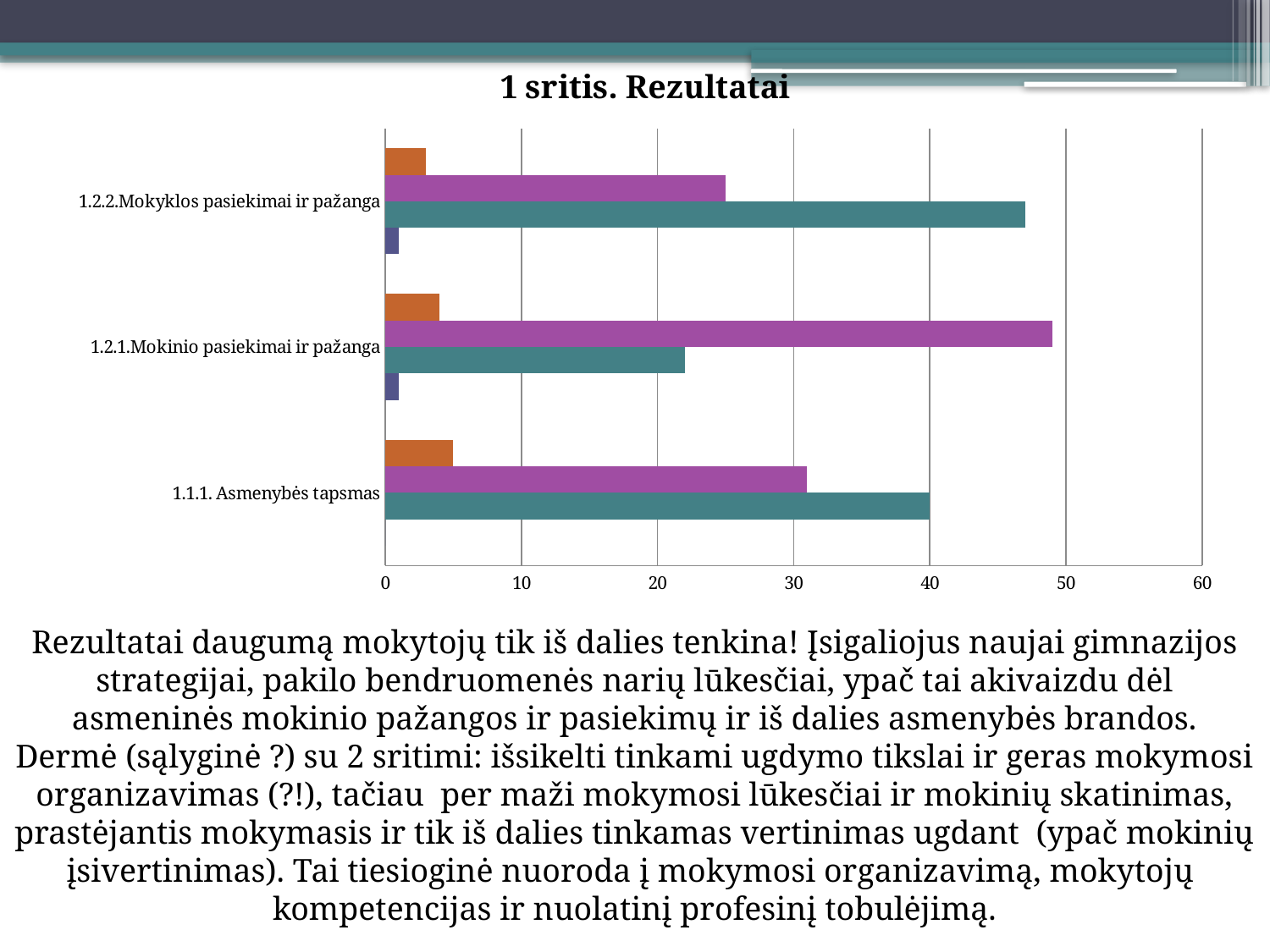
For 1.2.2.Mokyklos pasiekimai ir pažanga, which bar is longer, the teal one or the purple one? the teal one How many categories are shown on the vertical axis of the chart? 3 What kind of chart is shown on the slide? bar chart Which category has the shortest teal bar? 1.2.1.Mokinio pasiekimai ir pažanga Is the value of the teal bar for 1.2.1.Mokinio pasiekimai ir pažanga greater or less than 30? less Which category has the longest purple bar? 1.2.1.Mokinio pasiekimai ir pažanga Is the value of the teal bar for 1.2.2.Mokyklos pasiekimai ir pažanga greater or less than 40? greater Is the value of the orange bar for 1.1.1. Asmenybės tapsmas greater or less than 10? less For 1.2.1.Mokinio pasiekimai ir pažanga, which bar is longer, the purple one or the teal one? the purple one What is the title of the chart? 1 sritis. Rezultatai